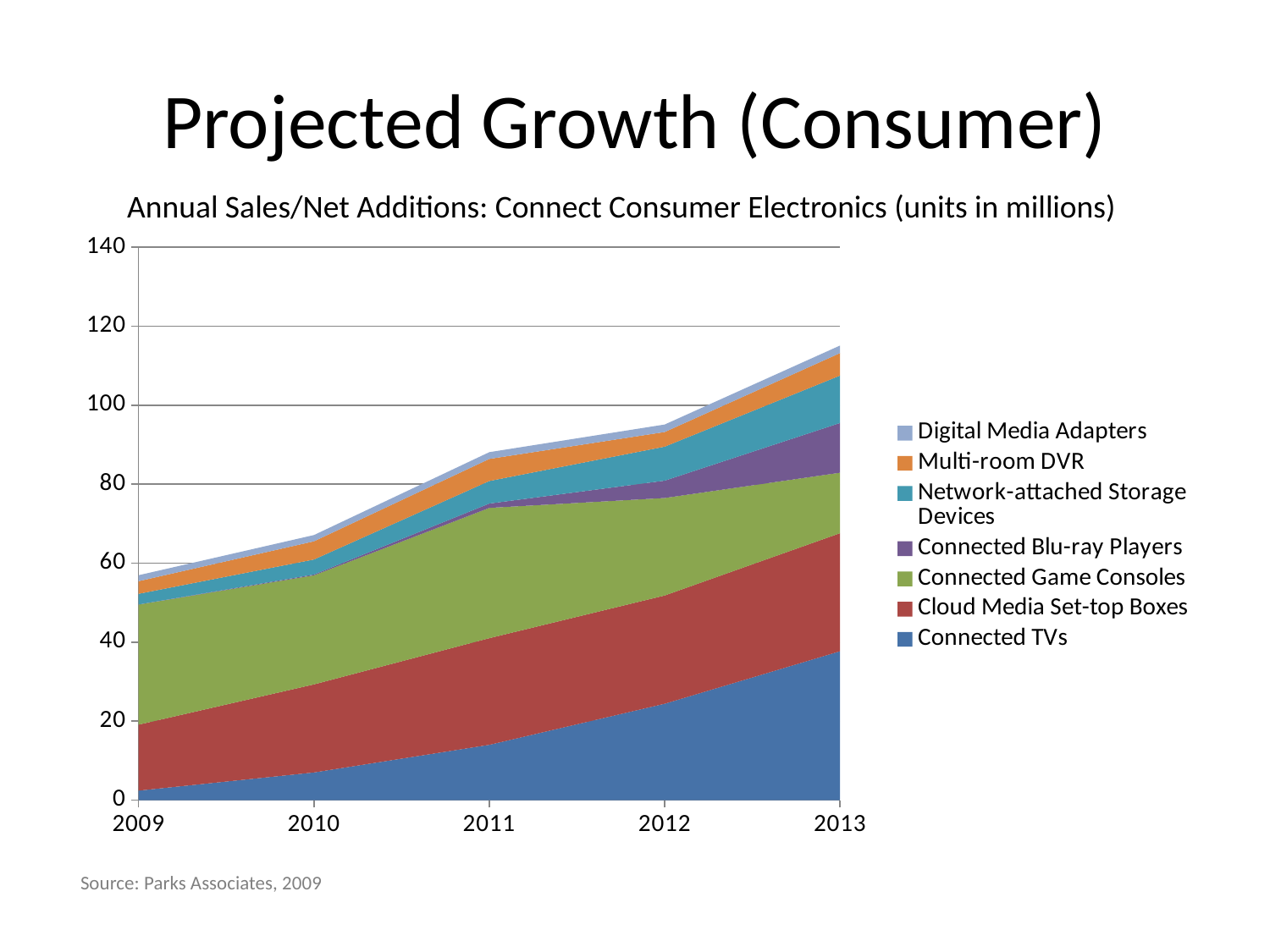
How many series does the legend list? 7 What kind of chart is shown on the slide? Stacked area chart Which is larger, the total stacked value for 2013 or for 2010? 2013 Which year has the lowest total stacked value? 2009 Is the value for Connected TVs in 2009 greater or less than 20? less Is the total stacked value for 2011 greater or less than 80? greater What is the title of the chart? Annual Sales/Net Additions: Connect Consumer Electronics (units in millions) Which year has the highest total stacked value? 2013 Is the total stacked value for 2009 greater or less than 60? less Does the total stacked value rise or fall from 2009 to 2013? Rises How many years are shown along the x axis? 5